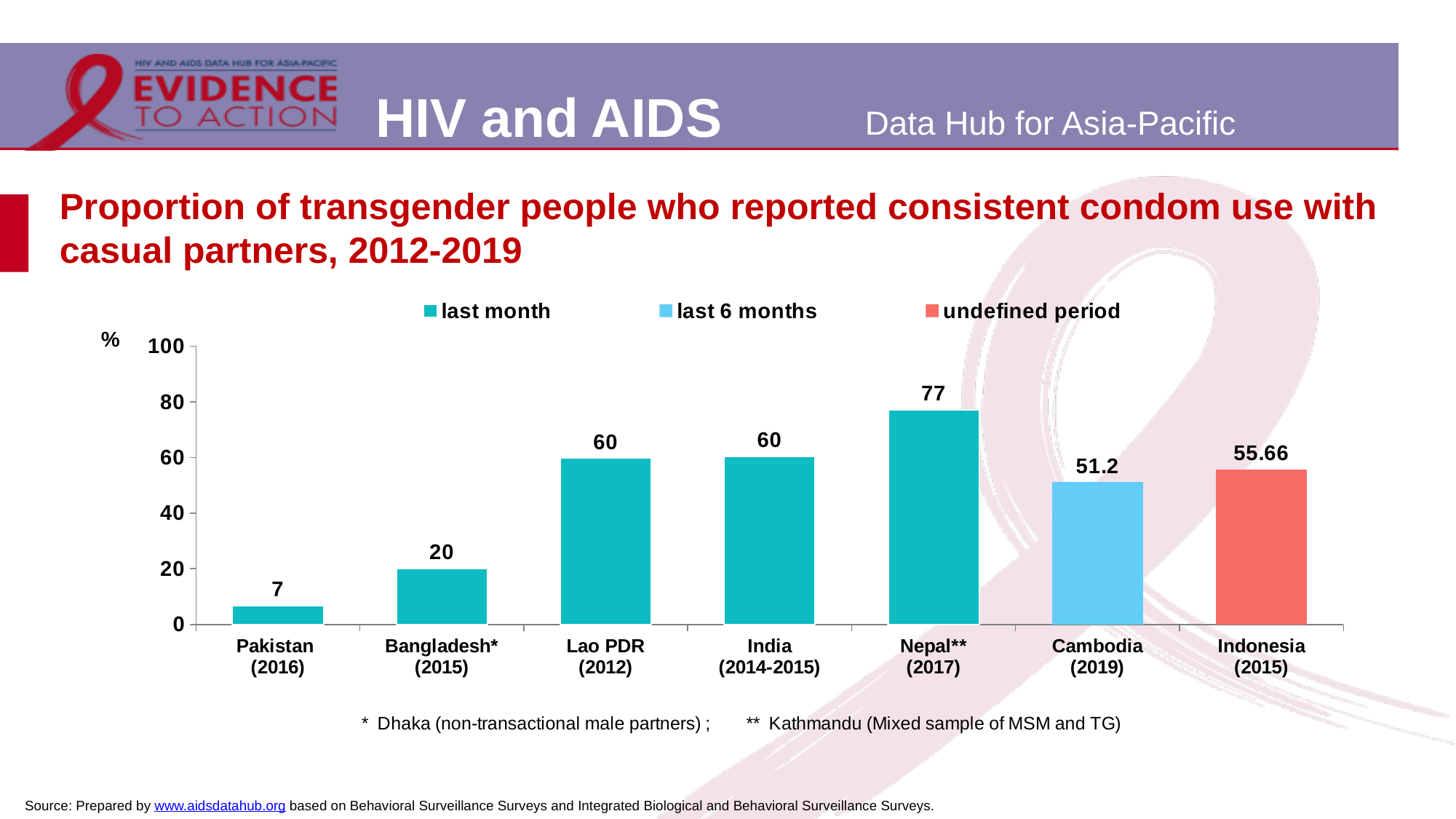
What is the value for Indonesia (2015)? 55.66 What is the value for Nepal** (2017)? 77 How many countries are shown on the chart? 7 What is the difference between the values for Nepal** (2017) and Pakistan (2016)? 70 Is the value for Bangladesh* (2015) greater or less than 40? less What kind of chart is shown? bar chart Which country has the highest value? Nepal** (2017) Which is larger, the value for Cambodia (2019) or Indonesia (2015)? Indonesia (2015) Which legend series does the Indonesia (2015) bar belong to? undefined period How many series does the legend list? 3 What is the value for Cambodia (2019)? 51.2 Which country has the lowest value? Pakistan (2016)